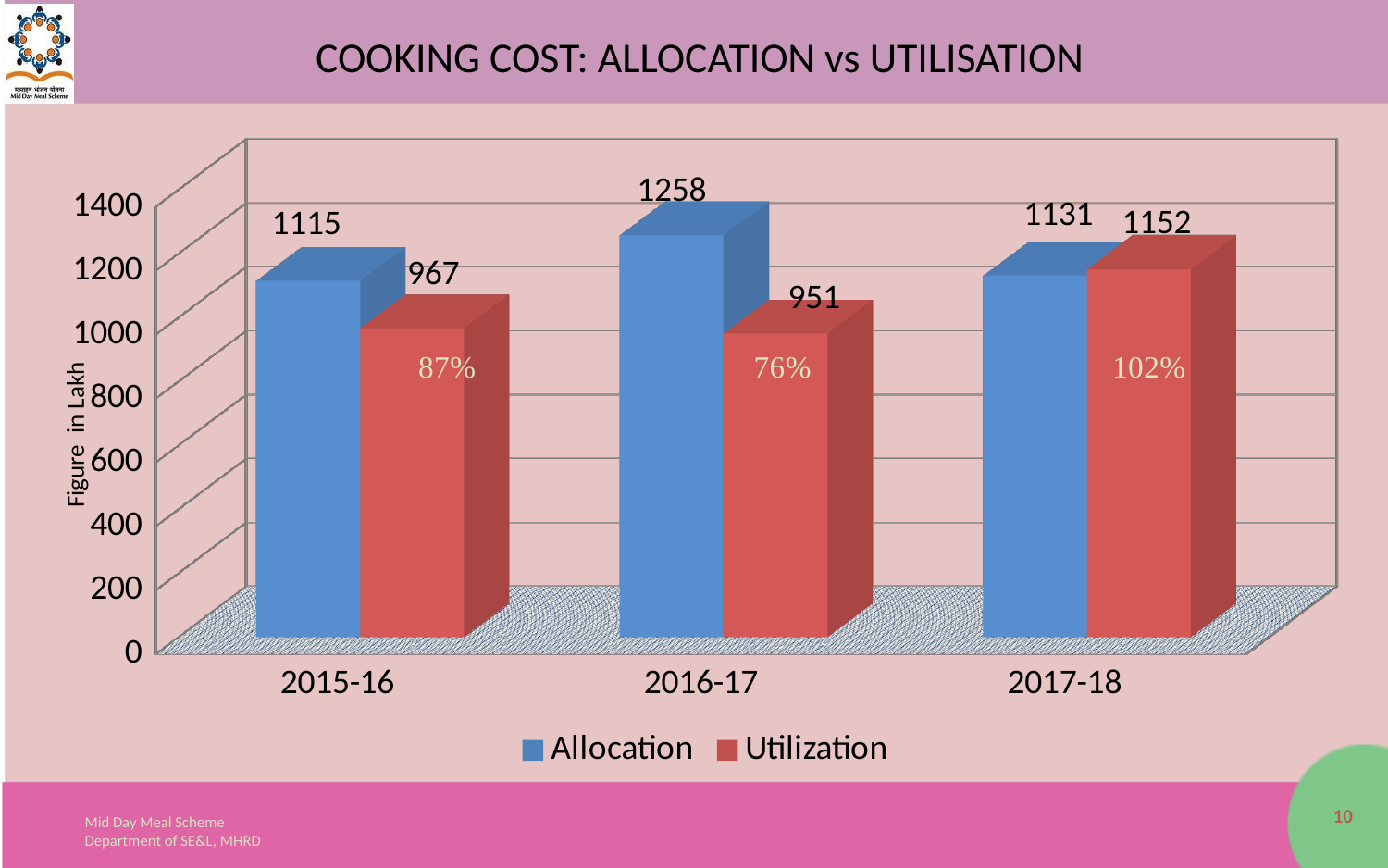
How many series does the legend list? 2 What percentage is shown on the Utilization bar for 2015-16? 87% What is the title of the chart? COOKING COST: ALLOCATION vs UTILISATION Which year has the highest Allocation value? 2016-17 What is the Utilization value for 2016-17? 951 What is the Allocation value for 2015-16? 1115 In 2017-18, which is larger, Allocation or Utilization? Utilization What kind of chart is shown on the slide? Bar chart What is the difference between Allocation and Utilization in 2016-17? 307 What is the Utilization value for 2017-18? 1152 Which year has the lowest Utilization value? 2016-17 How many years are shown on the x axis? 3